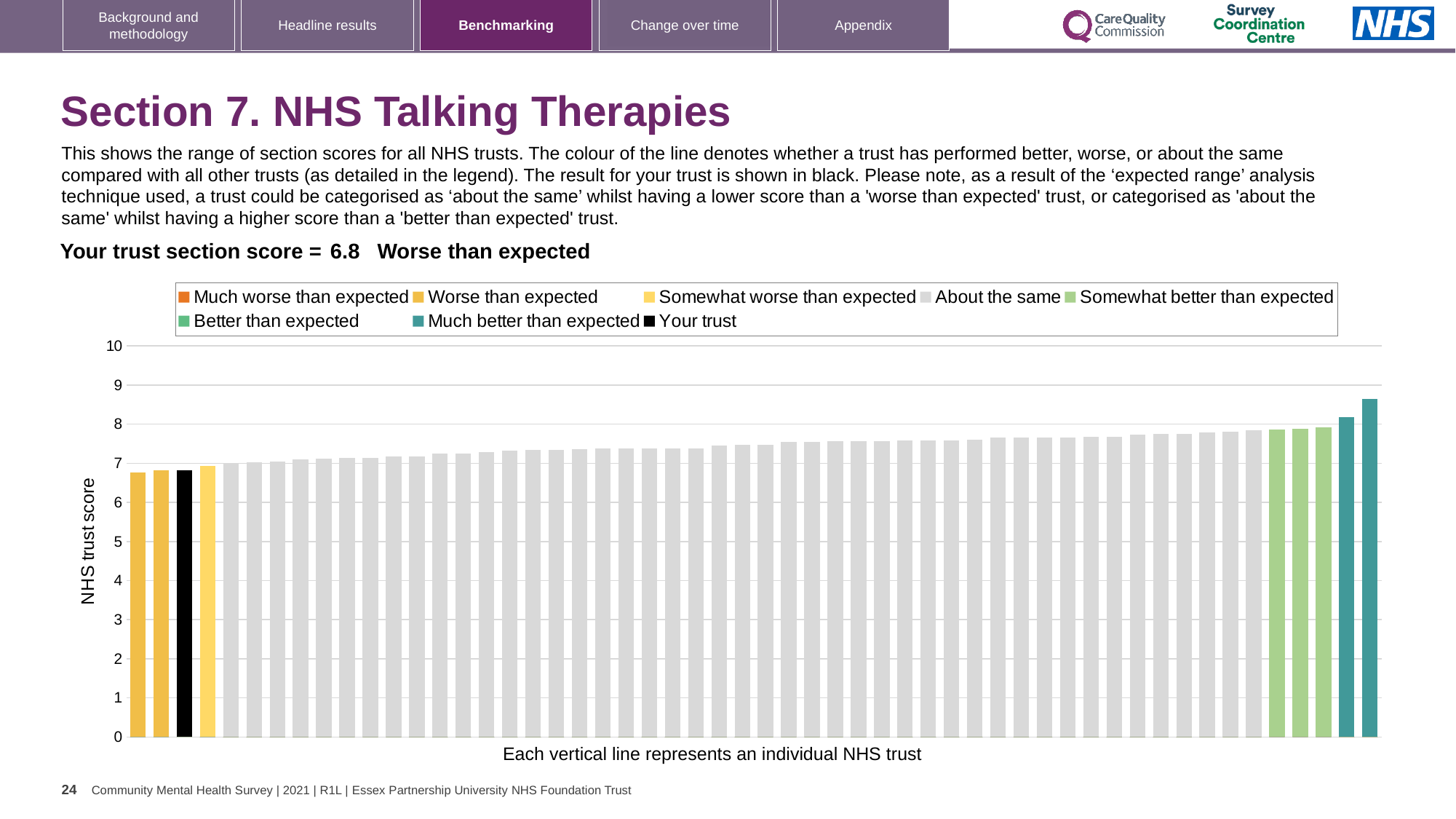
How many bars are coloured as 'Much better than expected' (teal)? 2 What is the section score for your trust shown on the slide? 6.8 Is the value of the shortest bar in the chart greater or less than 7? less Is the value of the tallest bar in the chart greater or less than 8? greater Is the value for your trust (the black bar) greater or less than 7? less Which performance category is your trust placed in according to the slide? Worse than expected Do the bar values rise or fall from left to right along the x axis? rise How many entries does the chart legend list? 8 How many bars are coloured as 'Somewhat better than expected' (light green)? 3 What is the label on the vertical axis of the chart? NHS trust score Which legend category does the tallest bar in the chart belong to? Much better than expected What kind of chart is shown on the slide? bar chart